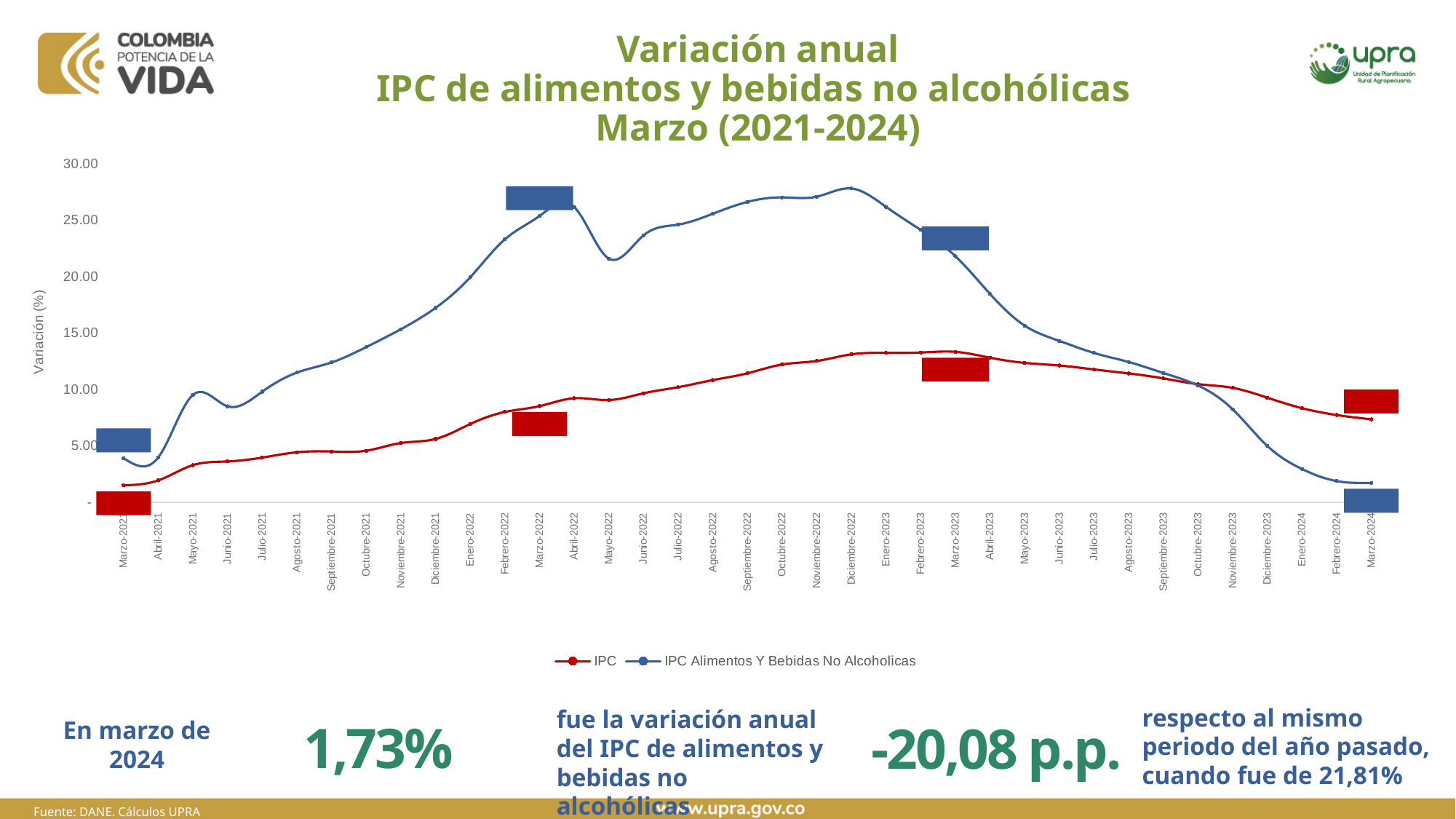
According to the slide, what was the annual variation of the IPC de alimentos y bebidas no alcohólicas in Marzo-2023? 21,81% How many months are plotted along the x axis, from Marzo-2021 to Marzo-2024? 37 What is the label on the vertical axis? Variación (%) In which month does the IPC Alimentos Y Bebidas No Alcoholicas series reach its highest value? Diciembre-2022 How many series does the legend list? 2 In Marzo-2024, which series has the higher value, IPC or IPC Alimentos Y Bebidas No Alcoholicas? IPC What are the two series named in the legend? IPC and IPC Alimentos Y Bebidas No Alcoholicas Is the value of the IPC series in Marzo-2024 greater or less than 10.00? less Does the IPC Alimentos Y Bebidas No Alcoholicas series rise or fall between Diciembre-2022 and Marzo-2024? Fall What kind of chart is shown on the slide? Line chart According to the slide, what was the annual variation of the IPC de alimentos y bebidas no alcohólicas in Marzo-2024? 1,73% Is the value of the IPC Alimentos Y Bebidas No Alcoholicas series in Diciembre-2022 greater or less than 25.00? greater